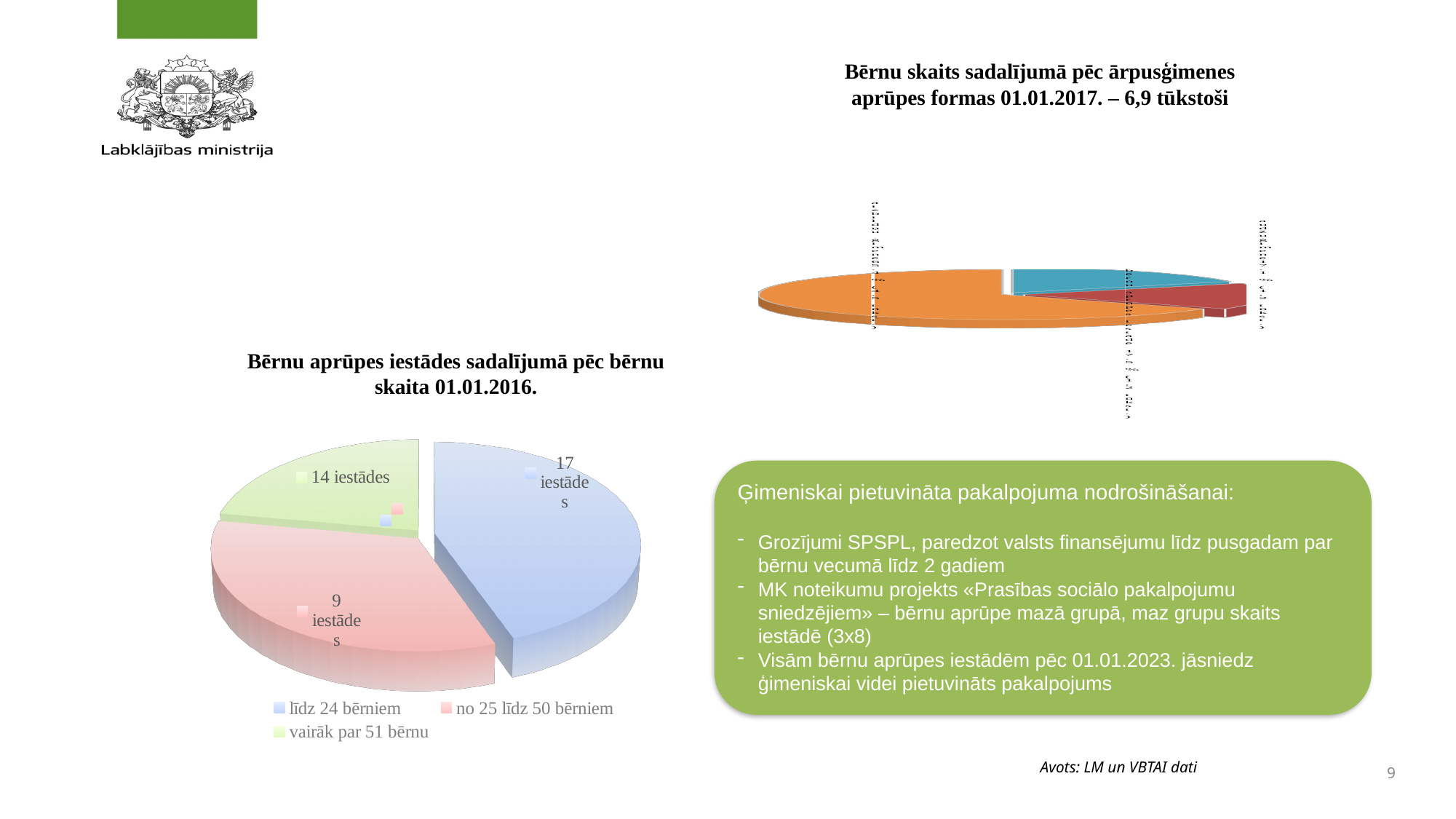
In the chart titled "Bērnu aprūpes iestādes sadalījumā pēc bērnu skaita 01.01.2016.", how many institutions are in the "vairāk par 51 bērnu" category? 14 iestādes In the chart titled "Bērnu aprūpes iestādes sadalījumā pēc bērnu skaita 01.01.2016.", which has more institutions: "vairāk par 51 bērnu" or "no 25 līdz 50 bērniem"? vairāk par 51 bērnu What is the title of the chart in the upper right of the slide? Bērnu skaits sadalījumā pēc ārpusģimenes aprūpes formas 01.01.2017. – 6,9 tūkstoši In the chart titled "Bērnu aprūpes iestādes sadalījumā pēc bērnu skaita 01.01.2016.", how many categories does the legend list? 3 In the chart titled "Bērnu aprūpes iestādes sadalījumā pēc bērnu skaita 01.01.2016.", which category has the most institutions? līdz 24 bērniem In the chart titled "Bērnu aprūpes iestādes sadalījumā pēc bērnu skaita 01.01.2016.", how many institutions are in the "līdz 24 bērniem" category? 17 iestādes What kind of chart is the one on the left of the slide, titled "Bērnu aprūpes iestādes sadalījumā pēc bērnu skaita 01.01.2016."? Pie chart In the chart titled "Bērnu aprūpes iestādes sadalījumā pēc bērnu skaita 01.01.2016.", which category has the fewest institutions? no 25 līdz 50 bērniem In the chart titled "Bērnu aprūpes iestādes sadalījumā pēc bērnu skaita 01.01.2016.", how many more institutions are in "līdz 24 bērniem" than in "no 25 līdz 50 bērniem"? 8 In the chart titled "Bērnu aprūpes iestādes sadalījumā pēc bērnu skaita 01.01.2016.", how many institutions are in the "no 25 līdz 50 bērniem" category? 9 iestādes In the chart titled "Bērnu aprūpes iestādes sadalījumā pēc bērnu skaita 01.01.2016.", what share of all institutions does the "vairāk par 51 bērnu" slice represent? 35% In the chart titled "Bērnu aprūpes iestādes sadalījumā pēc bērnu skaita 01.01.2016.", what is the total number of institutions across all three categories? 40